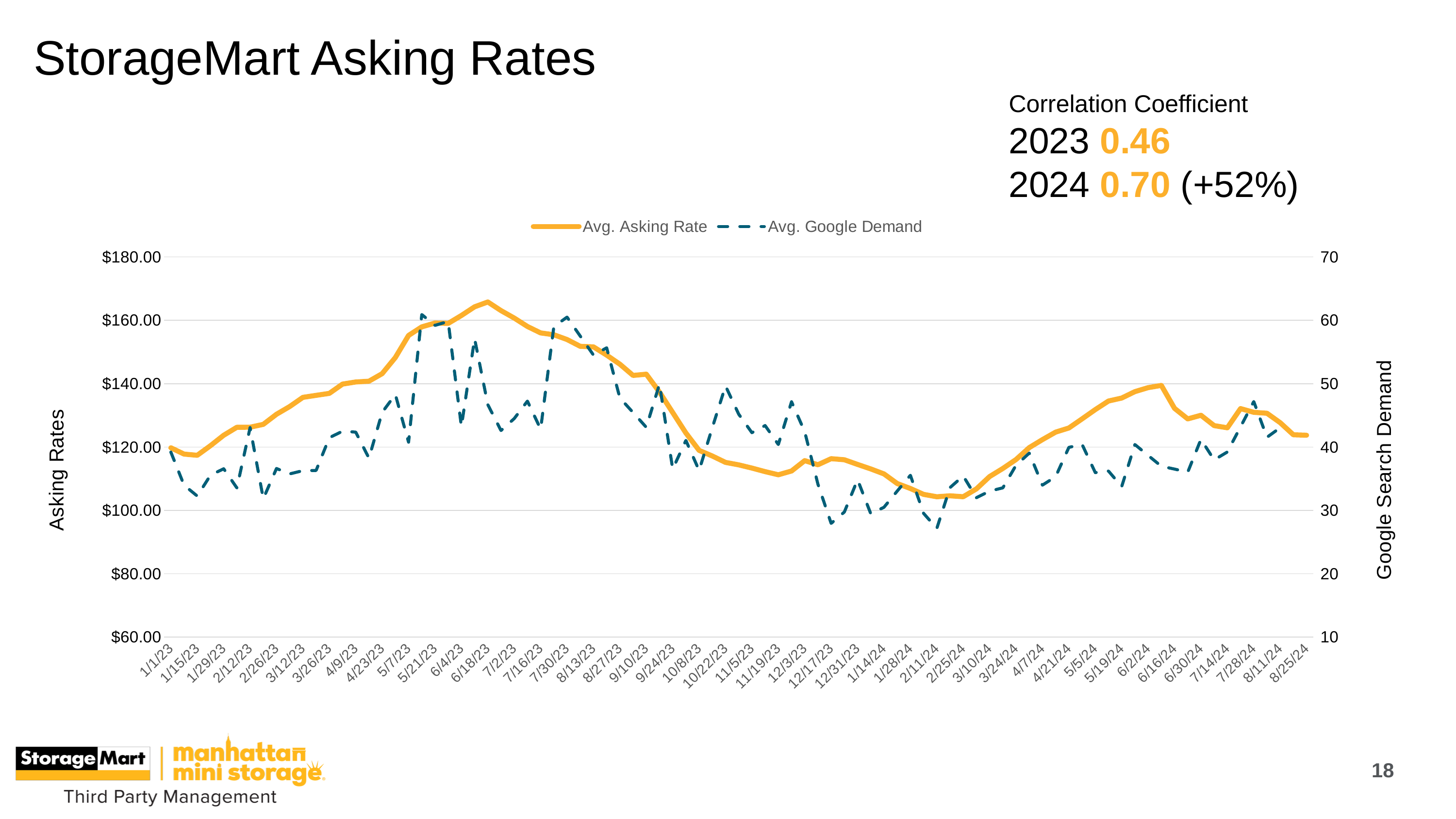
Is the Avg. Asking Rate value at 2/11/24 greater or less than $120.00? less Is the Avg. Asking Rate value at 1/1/23 greater or less than $140.00? less What are the two series named in the chart legend? Avg. Asking Rate and Avg. Google Demand Is the Avg. Asking Rate value at 6/18/23 greater or less than $160.00? greater How many series does the chart legend list? 2 What correlation coefficient is shown for 2024 on the slide? 0.70 On which date does the Avg. Asking Rate reach its highest point? 6/18/23 Which is higher, the Avg. Asking Rate at 6/18/23 or at 8/25/24? 6/18/23 Does the Avg. Asking Rate rise or fall between 6/18/23 and 2/11/24? fall What kind of chart is shown on the slide? Line chart